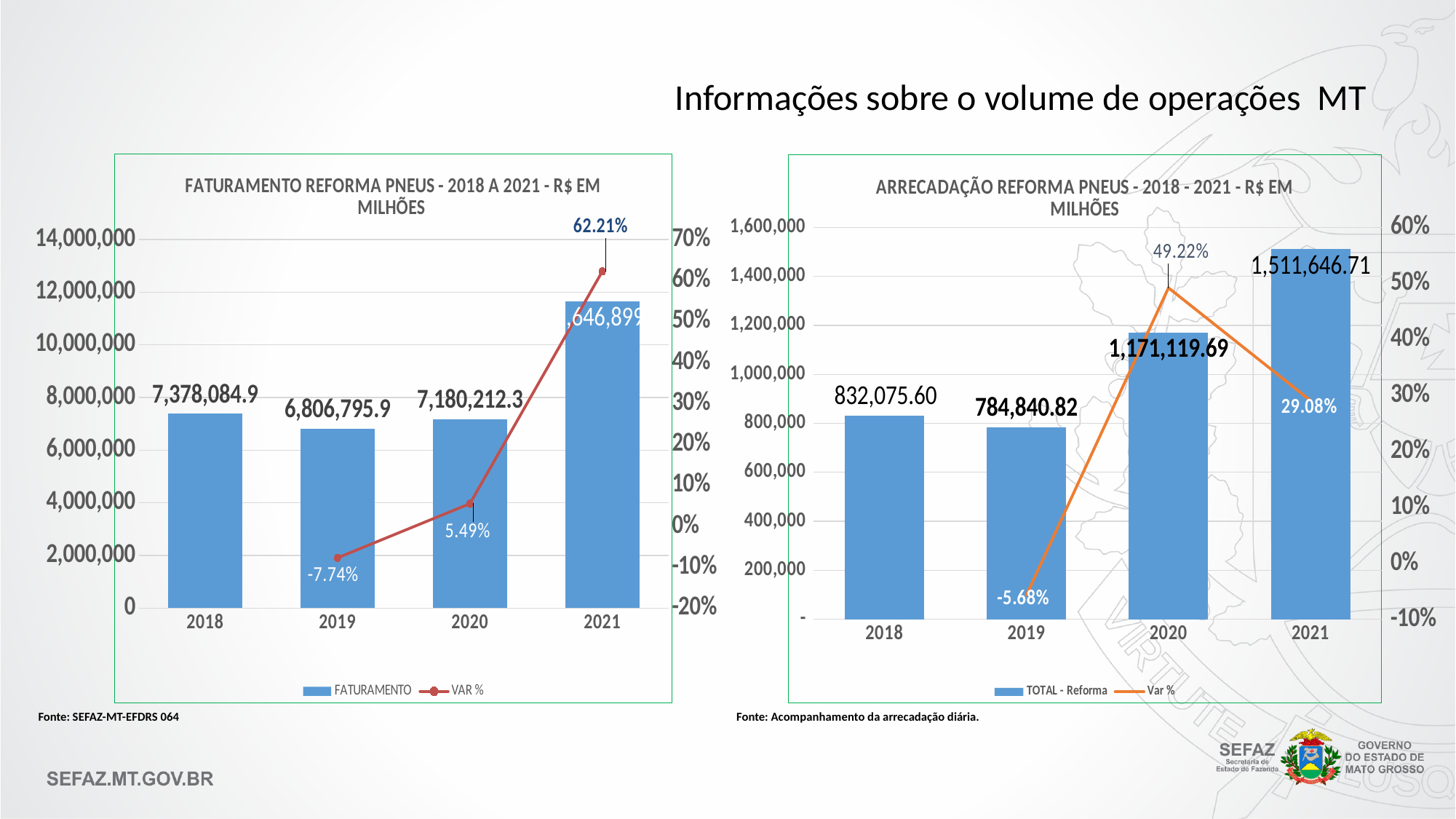
In the ARRECADAÇÃO REFORMA PNEUS chart, what is the difference between the TOTAL - Reforma values for 2021 and 2020? 340,527.02 In the ARRECADAÇÃO REFORMA PNEUS chart, how many series does the legend list? 2 In the ARRECADAÇÃO REFORMA PNEUS chart, what is the TOTAL - Reforma value for 2021? 1,511,646.71 In the FATURAMENTO REFORMA PNEUS chart, what is the FATURAMENTO value for 2018? 7,378,084.9 In the ARRECADAÇÃO REFORMA PNEUS chart, what is the Var % value for 2020? 49.22% In the ARRECADAÇÃO REFORMA PNEUS chart, which year has the lowest TOTAL - Reforma value? 2019 In the ARRECADAÇÃO REFORMA PNEUS chart, how many years are shown on the x axis? 4 In the FATURAMENTO REFORMA PNEUS chart, is the FATURAMENTO bar for 2021 greater or less than 10,000,000? greater In the FATURAMENTO REFORMA PNEUS chart, which year has the lowest FATURAMENTO value? 2019 In the FATURAMENTO REFORMA PNEUS chart, which year has the highest FATURAMENTO bar? 2021 In the FATURAMENTO REFORMA PNEUS chart, what is the VAR % value for 2021? 62.21% In the FATURAMENTO REFORMA PNEUS chart, what is the VAR % value for 2019? -7.74%